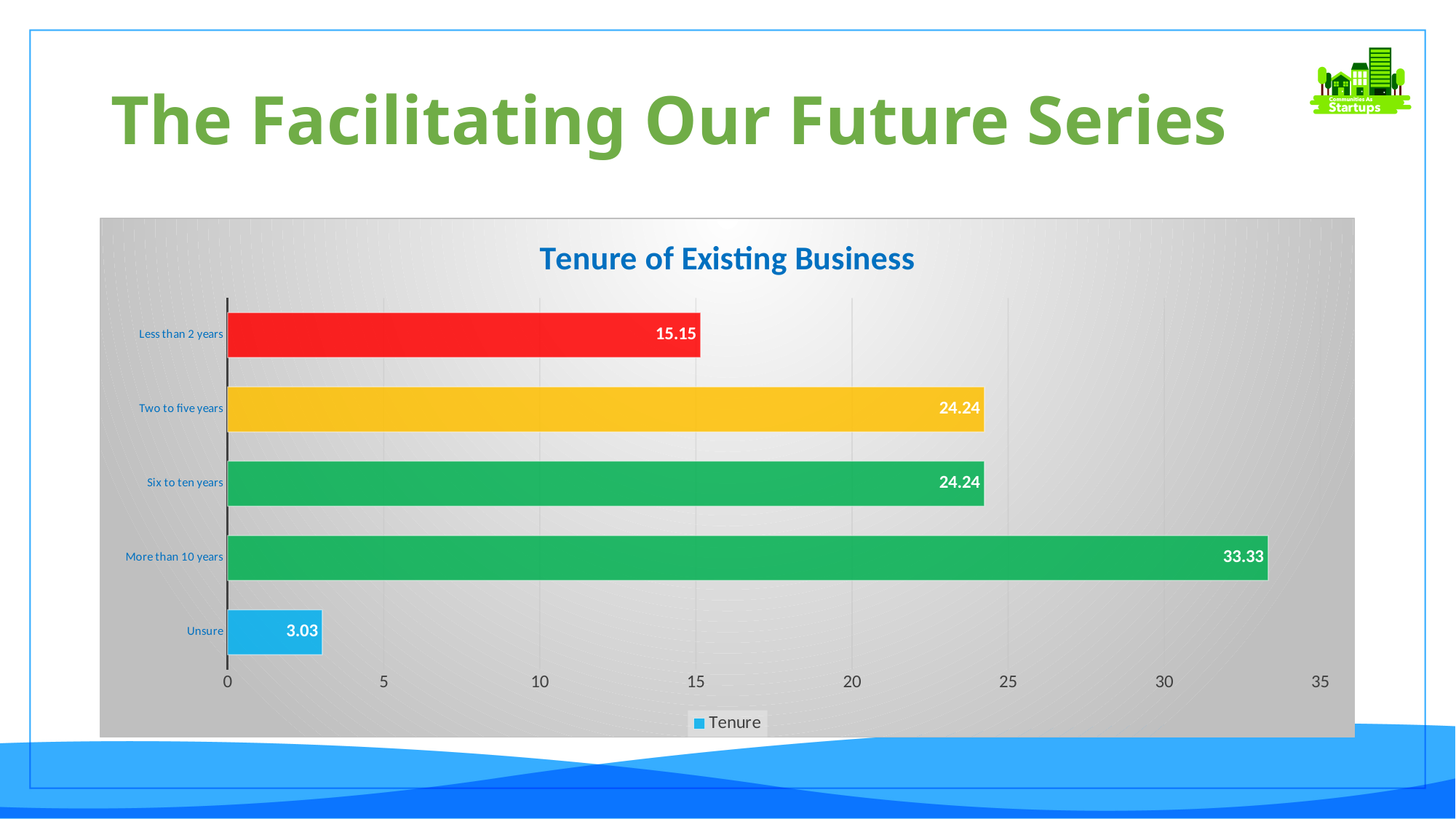
What kind of chart is shown on the slide? Bar chart Which category has the lowest value? Unsure What is the value for 'More than 10 years' in the Tenure of Existing Business chart? 33.33 Which category has the highest value? More than 10 years What is the value for 'Unsure'? 3.03 Is the value for 'More than 10 years' greater or less than 30? greater What is the difference between the values for 'More than 10 years' and 'Less than 2 years'? 18.18 What is the value for 'Two to five years'? 24.24 What is the title of the chart? Tenure of Existing Business What is the value for 'Less than 2 years'? 15.15 How many categories are shown in the chart? 5 Which is larger, the value for 'Six to ten years' or the value for 'Less than 2 years'? Six to ten years